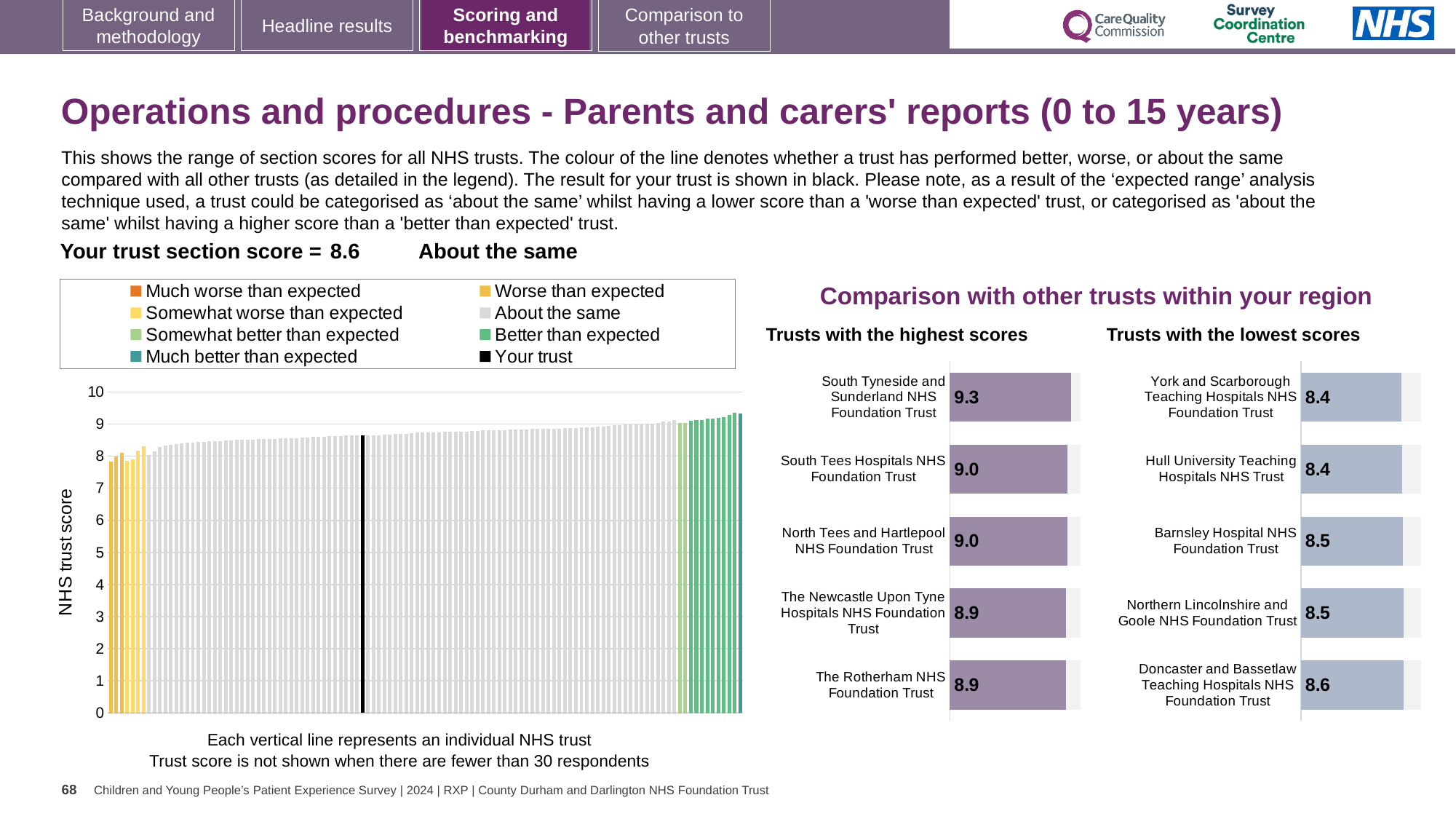
In the 'Trusts with the lowest scores' chart, what is the score for Doncaster and Bassetlaw Teaching Hospitals NHS Foundation Trust? 8.6 In the 'Trusts with the highest scores' chart, which trust has the highest score? South Tyneside and Sunderland NHS Foundation Trust How many entries does the legend of the large chart on the left list? 8 In the large chart on the left showing the range of section scores, is the value for your trust (the black line) greater or less than 8? greater How many trusts are shown in the 'Trusts with the highest scores' chart? 5 In the 'Trusts with the lowest scores' chart, what is the score for Hull University Teaching Hospitals NHS Trust? 8.4 In the 'Trusts with the highest scores' chart, what is the difference between the scores of South Tyneside and Sunderland NHS Foundation Trust and The Rotherham NHS Foundation Trust? 0.4 In the 'Trusts with the lowest scores' chart, what is the difference between the scores of Doncaster and Bassetlaw Teaching Hospitals NHS Foundation Trust and York and Scarborough Teaching Hospitals NHS Foundation Trust? 0.2 In the 'Trusts with the highest scores' chart, what is the score for The Rotherham NHS Foundation Trust? 8.9 In the 'Trusts with the lowest scores' chart, which trust has the highest score? Doncaster and Bassetlaw Teaching Hospitals NHS Foundation Trust Which has the higher score: South Tees Hospitals NHS Foundation Trust in the highest-scores chart or Barnsley Hospital NHS Foundation Trust in the lowest-scores chart? South Tees Hospitals NHS Foundation Trust In the 'Trusts with the highest scores' chart, what is the score for South Tyneside and Sunderland NHS Foundation Trust? 9.3